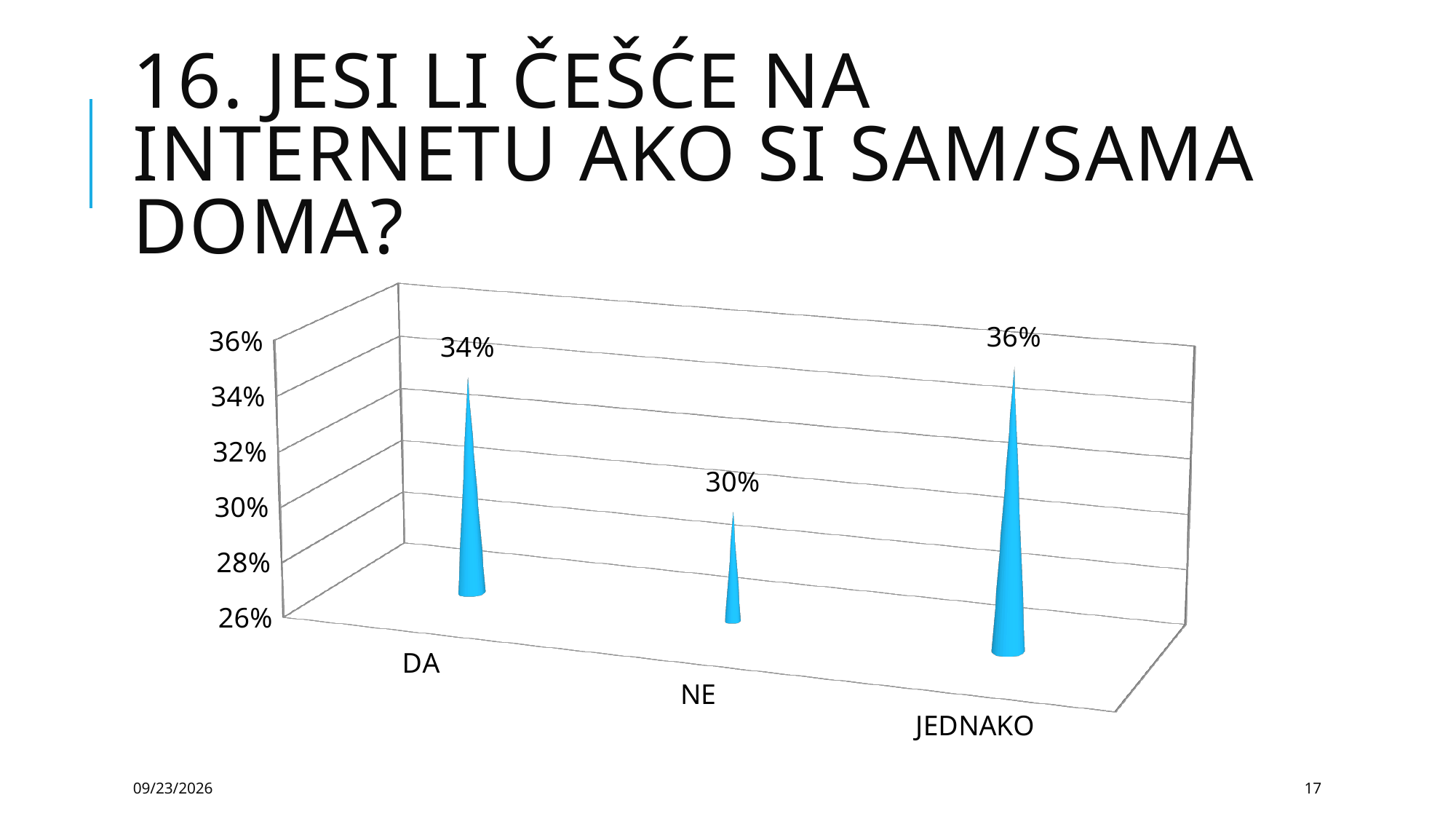
Which category has the highest value? JEDNAKO Which is larger, the value for DA or the value for JEDNAKO? JEDNAKO What kind of chart is shown on the slide? bar chart Is the value for NE greater or less than 32%? less Which category has the lowest value? NE What is the value for NE? 30% What is the difference between the values for JEDNAKO and NE? 6% What is the lowest value shown on the vertical axis? 26% What is the value for DA? 34% What is the value for JEDNAKO? 36% What is the difference between the values for DA and NE? 4% How many categories are shown on the chart? 3